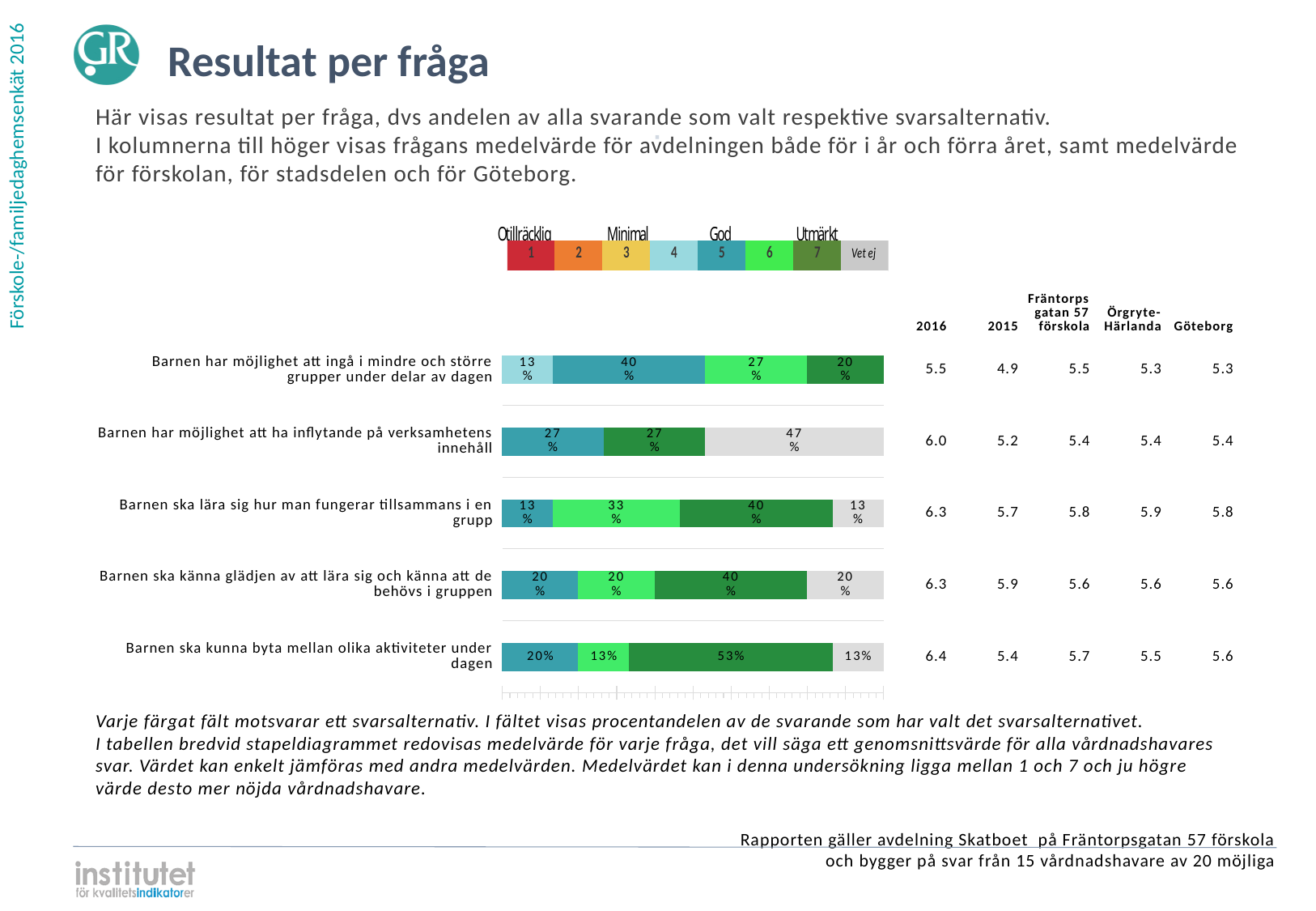
What is the difference between the 'Vet ej' share for 'Barnen har möjlighet att ha inflytande på verksamhetens innehåll' and the 'Vet ej' share for 'Barnen ska kunna byta mellan olika aktiviteter under dagen'? 34 percentage points What is the Göteborg mean value for 'Barnen har möjlighet att ingå i mindre och större grupper under delar av dagen'? 5.3 What is the 2016 mean value for 'Barnen ska kunna byta mellan olika aktiviteter under dagen'? 6.4 What kind of chart is shown on the slide? Stacked bar chart Which question has the largest single segment in its bar? Barnen ska kunna byta mellan olika aktiviteter under dagen Which is larger: the share choosing answer 7 for 'Barnen ska kunna byta mellan olika aktiviteter under dagen' or for 'Barnen ska känna glädjen av att lära sig och känna att de behövs i gruppen'? Barnen ska kunna byta mellan olika aktiviteter under dagen How many questions (categories) are plotted in the bar chart? 5 What percentage chose answer 6 for 'Barnen ska lära sig hur man fungerar tillsammans i en grupp'? 33% What percentage chose answer 7 (Utmärkt) for 'Barnen ska kunna byta mellan olika aktiviteter under dagen'? 53% What percentage chose answer 5 for 'Barnen har möjlighet att ingå i mindre och större grupper under delar av dagen'? 40% What percentage of respondents chose 'Vet ej' for 'Barnen har möjlighet att ha inflytande på verksamhetens innehåll'? 47% How many answer alternatives does the legend above the chart list? 8